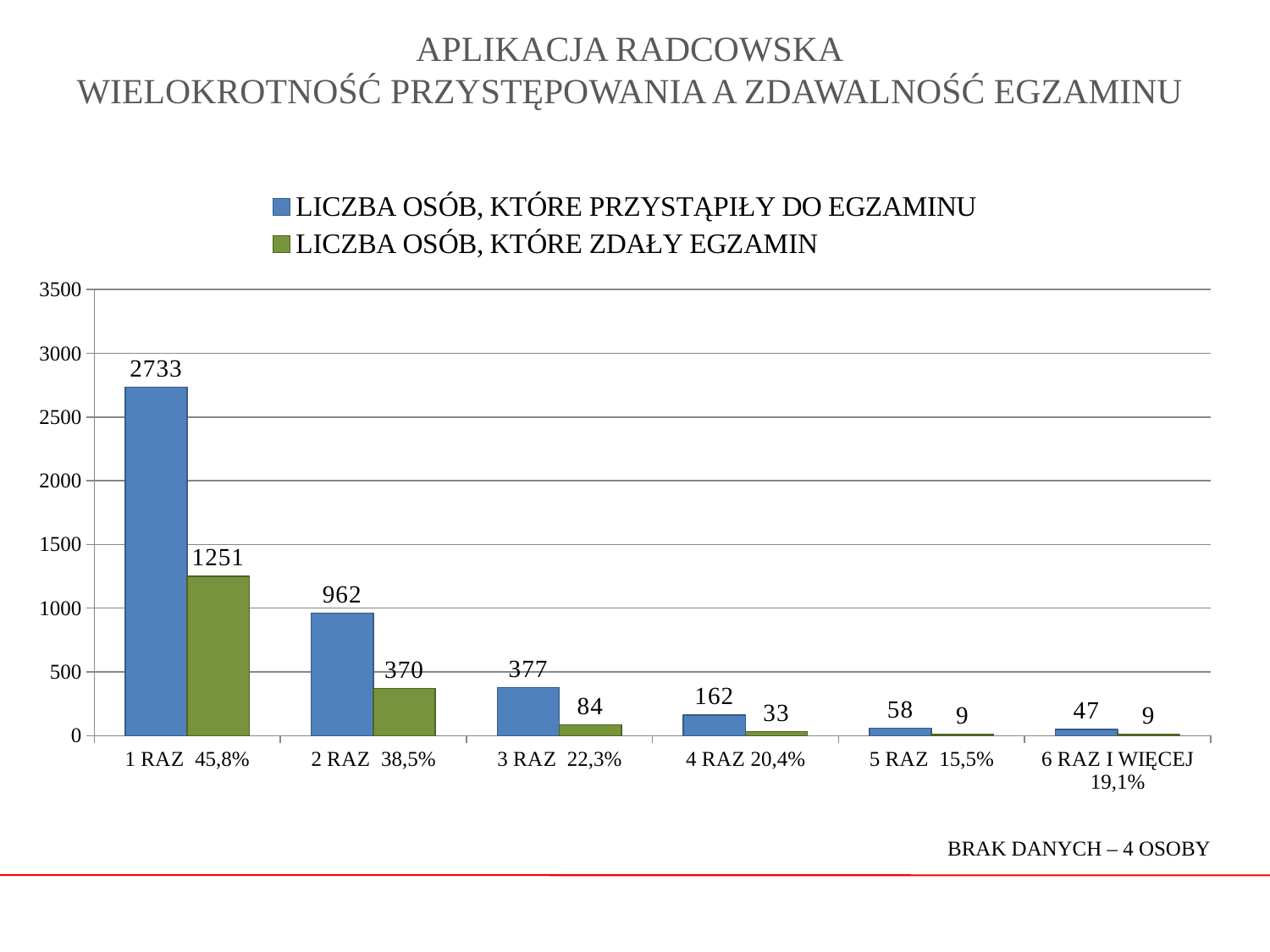
How many series does the legend list? 2 Which category has the highest number of people who took the exam? 1 RAZ 45,8% What is the difference between the number of people who took the exam for the 2nd time and the 3rd time? 585 How many categories are shown on the x axis? 6 What is the difference between the number of people who took the exam and the number who passed in the 1 RAZ category? 1482 What is the value for LICZBA OSÓB, KTÓRE PRZYSTĄPIŁY DO EGZAMINU in the 4 RAZ category? 162 How many people took the exam for the first time (1 RAZ) according to the chart? 2733 Do the values for the number of people who took the exam rise or fall from left to right along the x axis? Fall Which is larger: the number of people who passed on the 3rd attempt or the number who took the exam for the 4th time? 4 RAZ took the exam (162) How many people passed the exam on their second attempt (2 RAZ)? 370 Which category has the lowest number of people who took the exam? 6 RAZ I WIĘCEJ 19,1% What kind of chart is shown on the slide? Bar chart